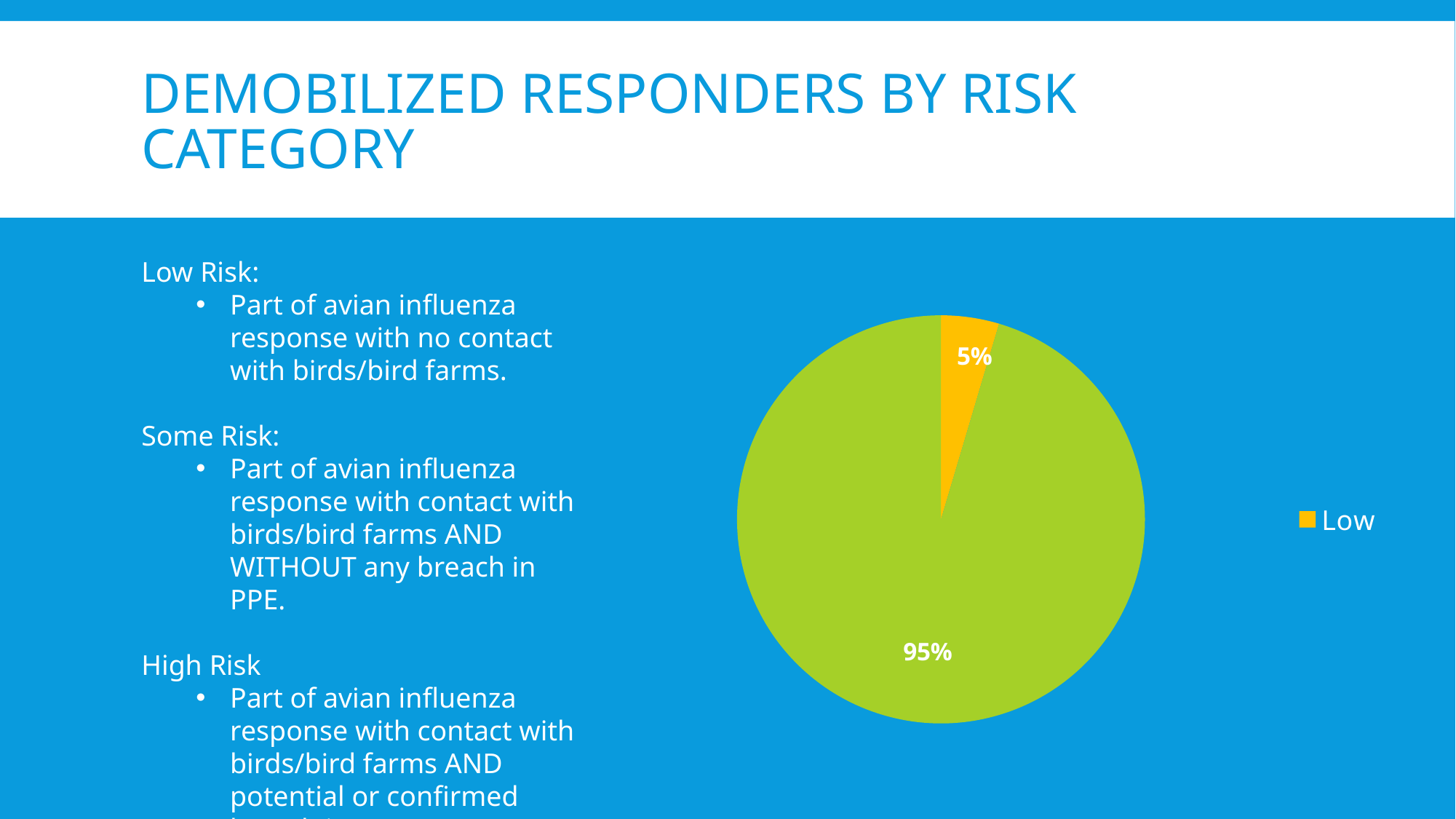
What do the two labelled slices of the pie add up to? 100% What is the title of the slide containing the pie chart? Demobilized Responders by Risk Category Is the Low slice the larger or the smaller of the two slices? smaller How many entries does the chart legend list? 1 What is the value shown on the largest slice of the pie? 95% What is the value shown on the smallest slice of the pie? 5% What colour is the Low slice of the pie? orange What kind of chart is shown on the slide? pie chart What is the difference between the two slice values shown on the pie chart? 90% What share of the pie does the Low slice represent? 5% How many slices does the pie chart have? 2